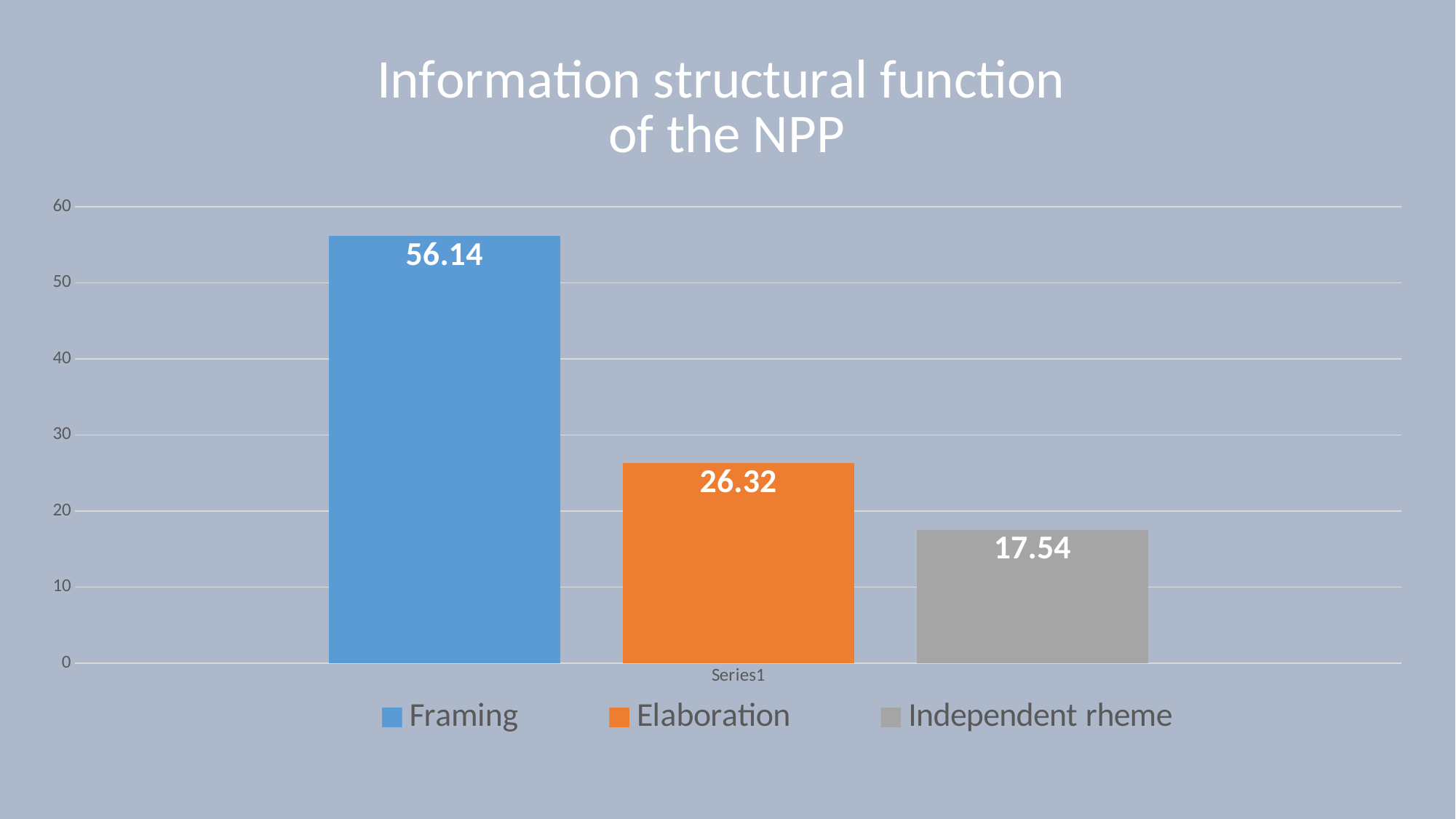
Which series has the highest value? Framing What is the value for Independent rheme? 17.54 What is the value for Framing? 56.14 Is the value for Framing greater or less than 50? greater How many series does the legend list? 3 What is the value for Elaboration? 26.32 Which is larger, the value for Elaboration or the value for Independent rheme? Elaboration What kind of chart is shown on the slide? bar chart What is the title of the chart? Information structural function of the NPP Which series has the lowest value? Independent rheme What is the difference between the values for Framing and Elaboration? 29.82 What is the difference between the values for Elaboration and Independent rheme? 8.78